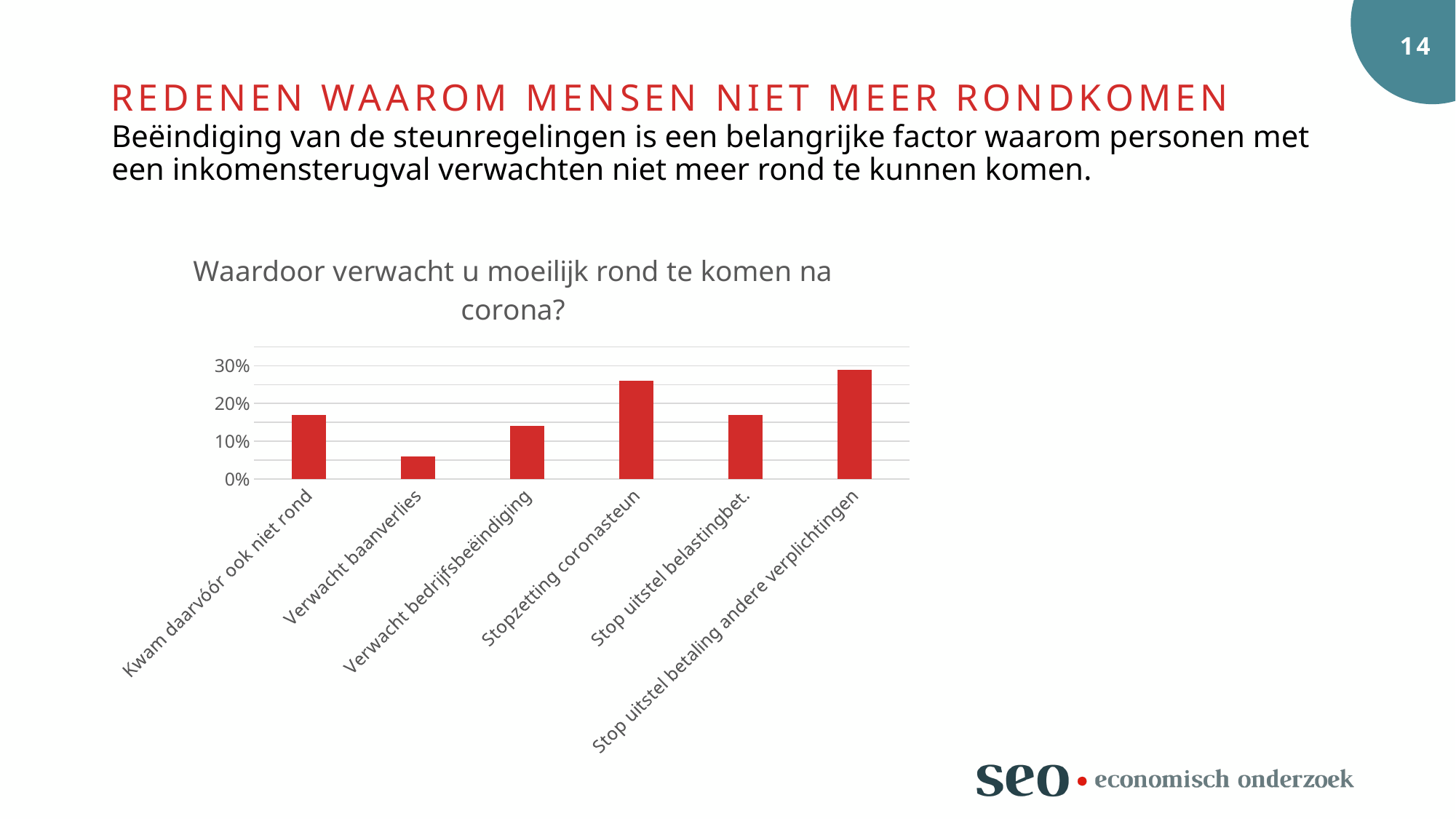
What is the title of the chart? Waardoor verwacht u moeilijk rond te komen na corona? What kind of chart is shown on the slide? bar chart Is the value for Verwacht bedrijfsbeëindiging greater or less than 10%? greater Which category has the highest bar in the chart? Stop uitstel betaling andere verplichtingen Which category has the lowest bar in the chart? Verwacht baanverlies Which is larger: the value for Verwacht baanverlies or the value for Verwacht bedrijfsbeëindiging? Verwacht bedrijfsbeëindiging Is the value for Kwam daarvóór ook niet rond greater or less than 20%? less How many categories are shown on the x axis of the chart? 6 Which is larger: the value for Stopzetting coronasteun or the value for Verwacht bedrijfsbeëindiging? Stopzetting coronasteun Is the value for Stopzetting coronasteun greater or less than 20%? greater